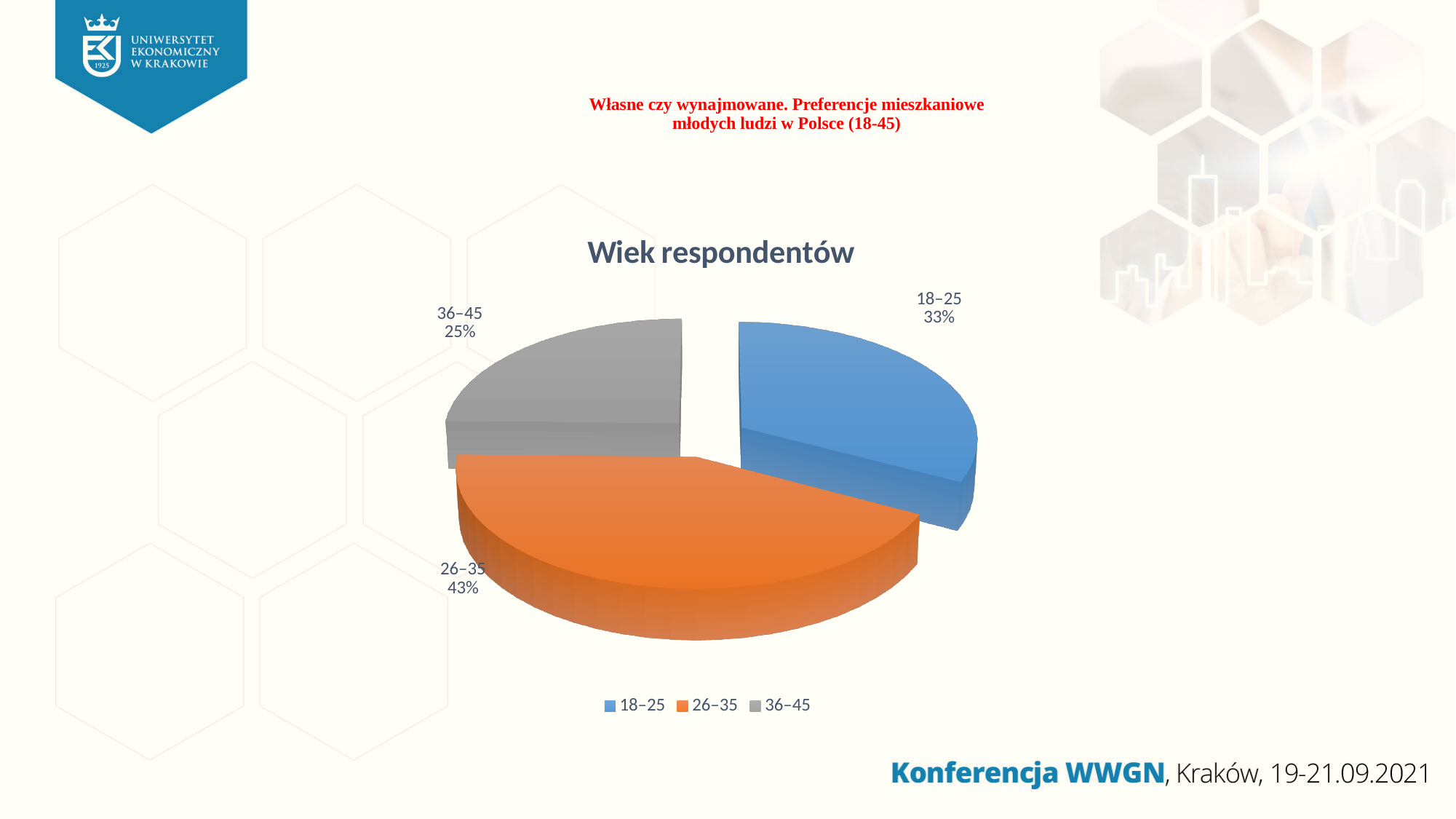
How many age groups are shown in the pie chart? 3 What share of respondents are aged 18–25? 33% What is the difference in percentage points between the 26–35 and 18–25 groups? 10 What share of respondents are aged 26–35? 43% Which age group has the largest share of respondents? 26–35 Which age group has the smallest share of respondents? 36–45 What share of respondents are aged 36–45? 25% What is the difference in percentage points between the 18–25 and 36–45 groups? 8 Which group has a larger share: 18–25 or 36–45? 18–25 What type of chart is shown on the slide? pie chart Which colour represents the 26–35 age group? orange What is the title of the chart? Wiek respondentów